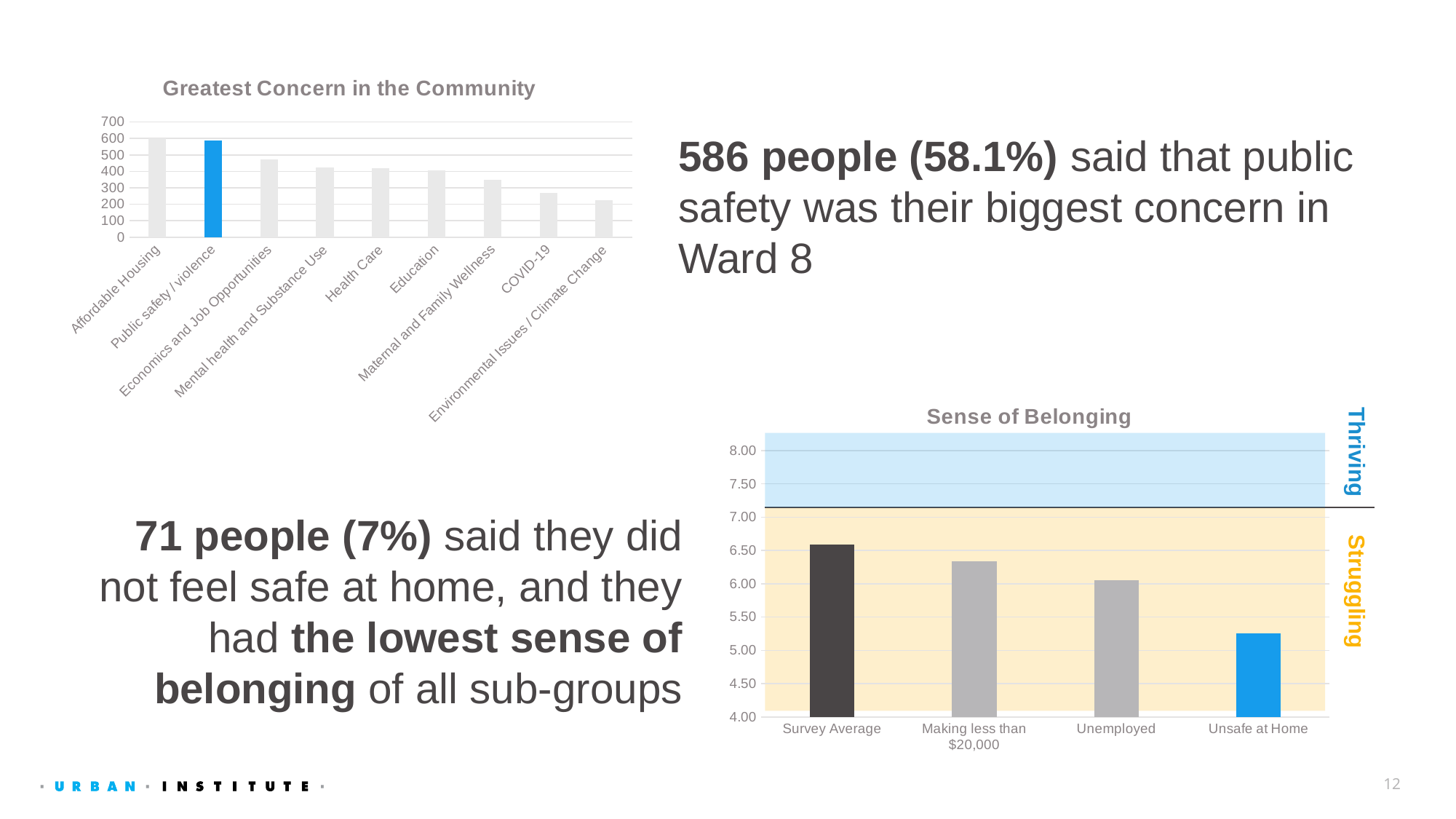
How many categories are shown in the 'Greatest Concern in the Community' chart? 9 In the 'Sense of Belonging' chart, which category has the lowest value? Unsafe at Home In the 'Greatest Concern in the Community' chart, which is larger: Maternal and Family Wellness or COVID-19? Maternal and Family Wellness How many categories are shown in the 'Sense of Belonging' chart? 4 In the 'Sense of Belonging' chart, which category has the highest value? Survey Average In the 'Sense of Belonging' chart, do the values rise or fall from left to right? fall In the 'Greatest Concern in the Community' chart, which bar is highlighted in blue? Public safety / violence In the 'Sense of Belonging' chart, is the value for Unsafe at Home greater or less than 5.50? less In the 'Greatest Concern in the Community' chart, is the value for COVID-19 greater or less than 300? less In the 'Greatest Concern in the Community' chart, is the value for Affordable Housing greater or less than 500? greater What kind of chart is the 'Greatest Concern in the Community' chart? bar chart In the 'Greatest Concern in the Community' chart, which category has the lowest value? Environmental Issues / Climate Change